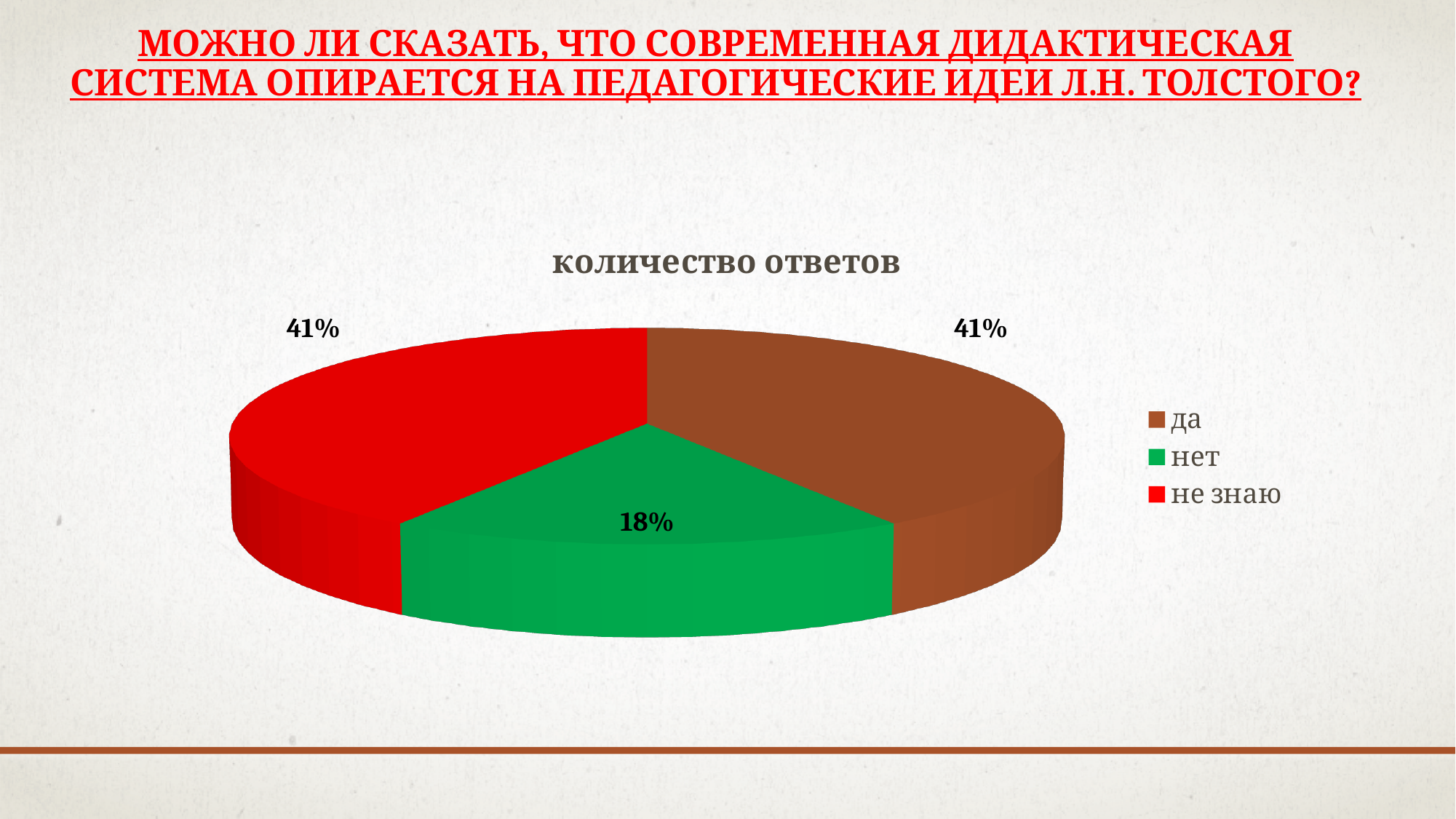
How many slices does the pie chart have? 3 What percentage of answers is "да"? 41% What is the combined share of "да" and "не знаю"? 82% What percentage of answers is "не знаю"? 41% Which answer has the smallest share of the pie? нет What is the title of the chart? количество ответов What colour represents "нет" in the chart? green What is the difference in percentage points between "да" and "нет"? 23 What type of chart is shown on the slide? pie chart What percentage of answers is "нет"? 18% Which is larger, the share for "не знаю" or the share for "нет"? не знаю How many entries does the legend list? 3